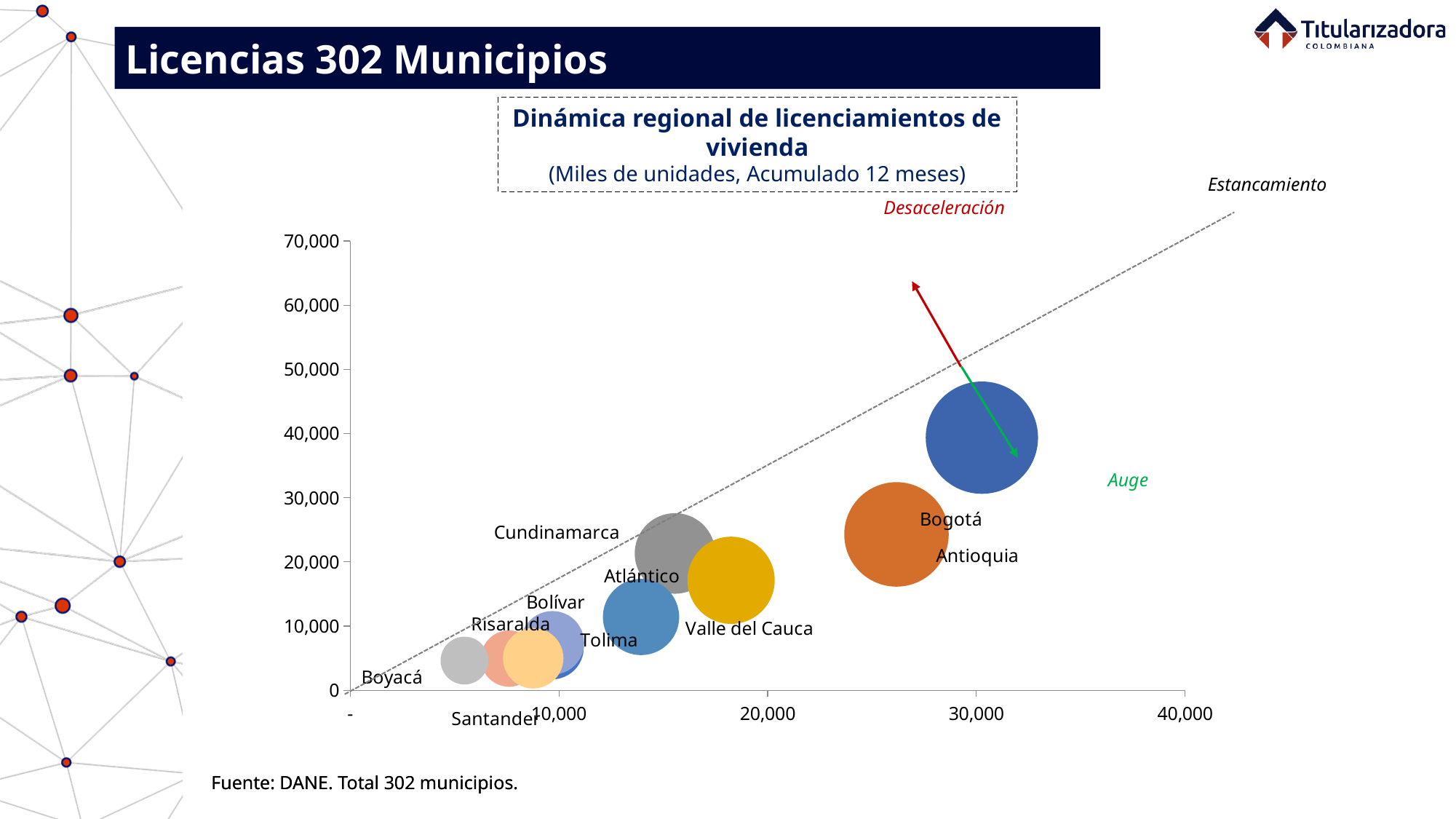
Is the horizontal-axis value for Antioquia greater or less than 20,000? greater Is the vertical-axis value for Bogotá greater or less than 30,000? greater What is the highest value shown on the vertical axis of the chart? 70,000 Which bubble is positioned higher on the vertical axis, Bogotá or Antioquia? Bogotá Which bubble is positioned higher on the vertical axis, Cundinamarca or Boyacá? Cundinamarca Is the vertical-axis value for Antioquia greater or less than 30,000? less What kind of chart is shown on the slide? Bubble chart What is the title of the chart? Dinámica regional de licenciamientos de vivienda Which region has the largest bubble in the chart? Bogotá Which region's bubble is highest on the vertical axis? Bogotá